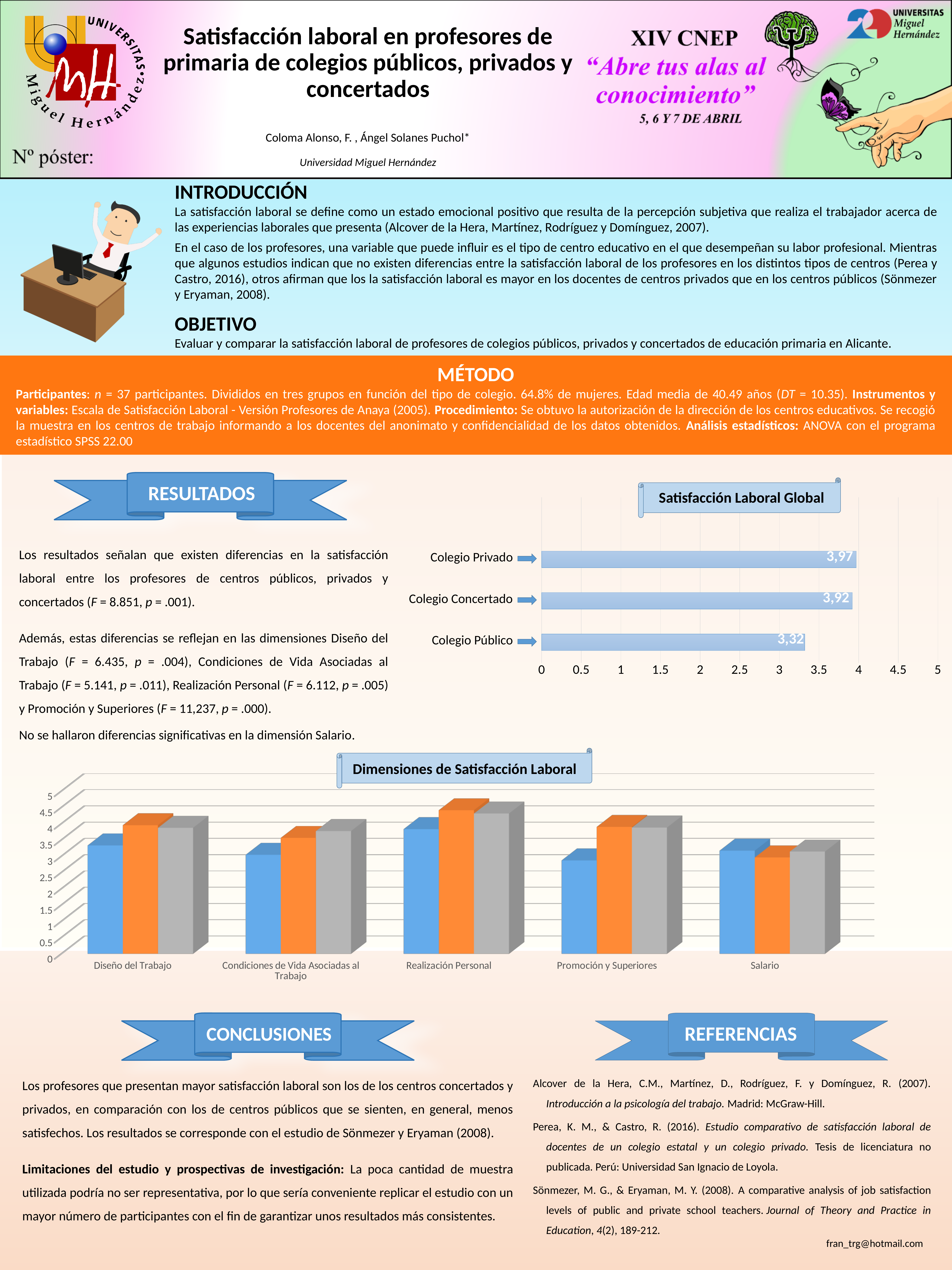
In the 'Satisfacción Laboral Global' chart, which category has the highest value? Colegio Privado In the 'Satisfacción Laboral Global' chart, what is the value for Colegio Privado? 3,97 In the 'Satisfacción Laboral Global' chart, which is larger: the value for Colegio Concertado or Colegio Público? Colegio Concertado In the 'Satisfacción Laboral Global' chart, what is the value for Colegio Público? 3,32 In the 'Dimensiones de Satisfacción Laboral' chart, how many categories are shown on the x axis? 5 In the 'Satisfacción Laboral Global' chart, how many categories are shown? 3 In the 'Satisfacción Laboral Global' chart, which category has the lowest value? Colegio Público In the 'Dimensiones de Satisfacción Laboral' chart, which category has the highest orange bar? Realización Personal What kind of chart is 'Satisfacción Laboral Global'? Bar chart In the 'Dimensiones de Satisfacción Laboral' chart, is the value of the blue bar for Promoción y Superiores greater or less than 3.5? less In the 'Satisfacción Laboral Global' chart, what is the difference between the values for Colegio Privado and Colegio Público? 0,65 In the 'Dimensiones de Satisfacción Laboral' chart, is the value of the orange bar for Realización Personal greater or less than 4? greater